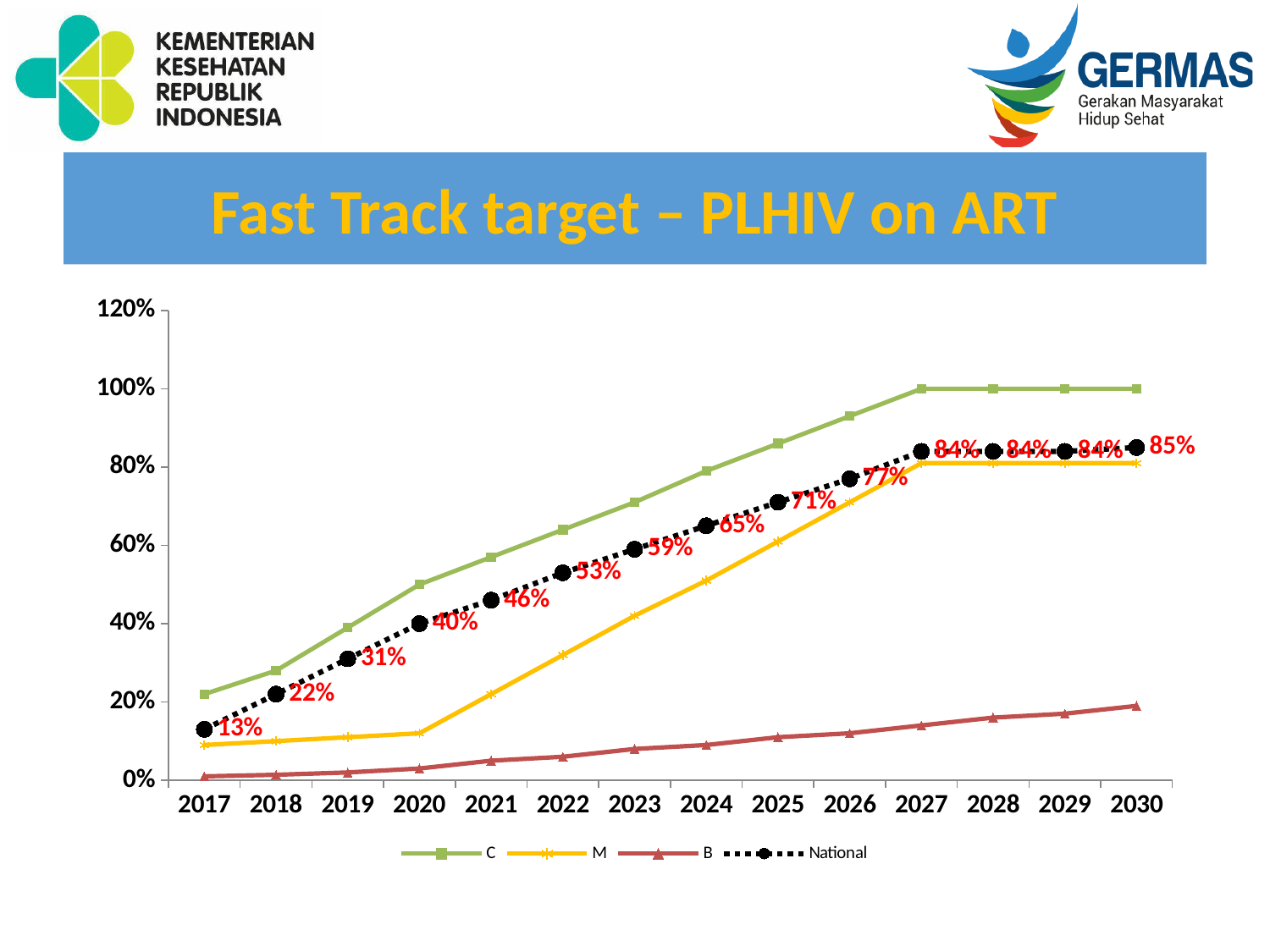
Which series is higher in 2020, C or M? C In which year does the National series reach its highest value? 2030 What kind of chart is shown on the slide? Line chart What is the value for the National series in 2017? 13% How many years are shown on the x axis? 14 What is the value for the National series in 2030? 85% Is the value for series C in 2025 greater or less than 80%? greater What is the value for the National series in 2022? 53% Which series has the lowest value in 2030? B What is the difference between the National values for 2027 and 2017? 71% Is the value for series B in 2024 greater or less than 20%? less How many series does the legend list? 4